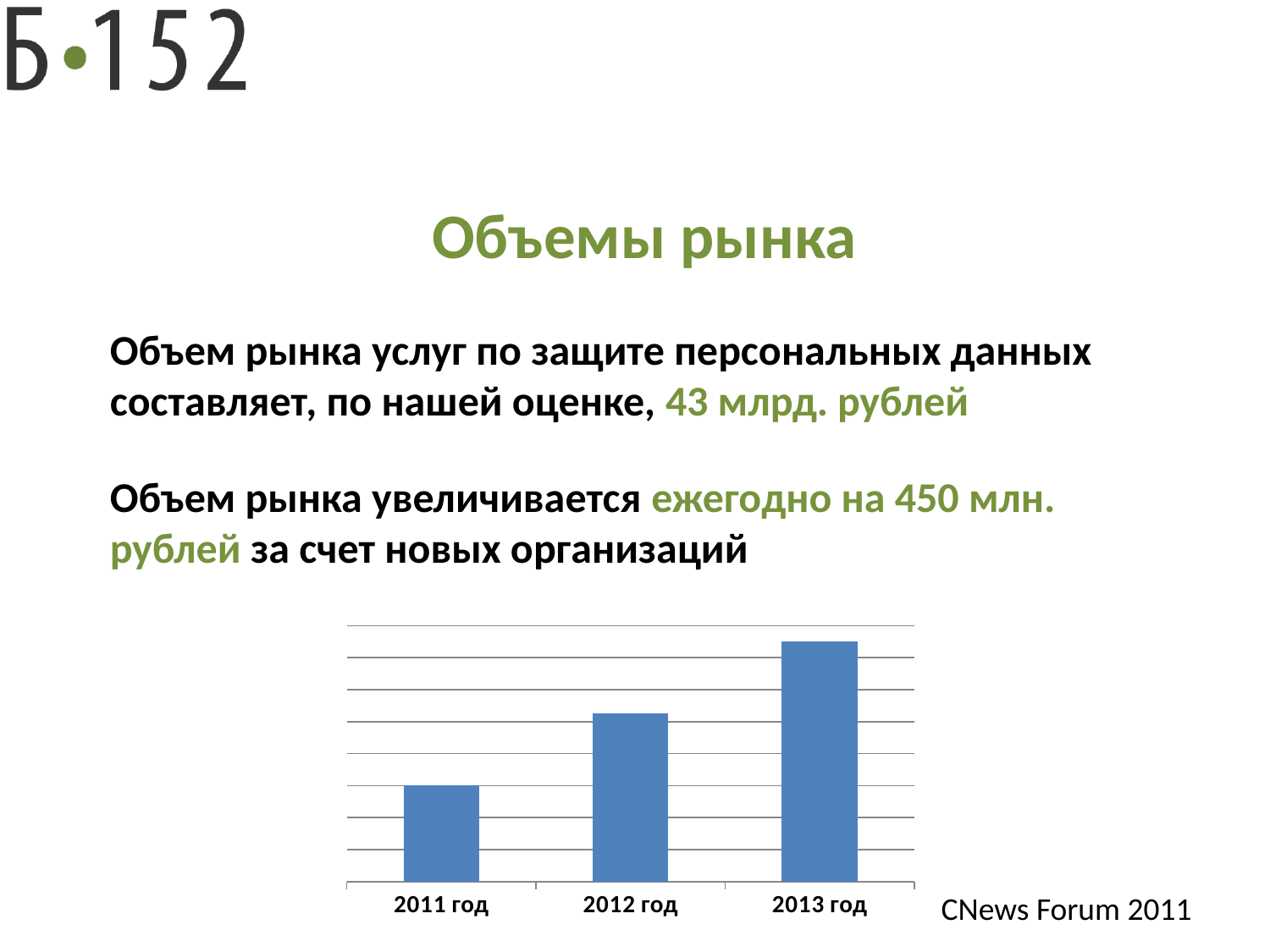
Which year has the highest bar in the chart? 2013 год Which is larger in the chart, the bar for 2013 год or the bar for 2012 год? 2013 год Which year has the lowest bar in the chart? 2011 год What kind of chart is shown on the slide? bar chart What is the label of the last category on the x axis of the chart? 2013 год What is the title of the slide containing the chart? Объемы рынка Do the bar values rise or fall from 2011 год to 2013 год? rise What is the label of the first category on the x axis of the chart? 2011 год What colour are the bars in the chart? blue How many categories (bars) does the chart show? 3 Which is larger in the chart, the bar for 2012 год or the bar for 2011 год? 2012 год